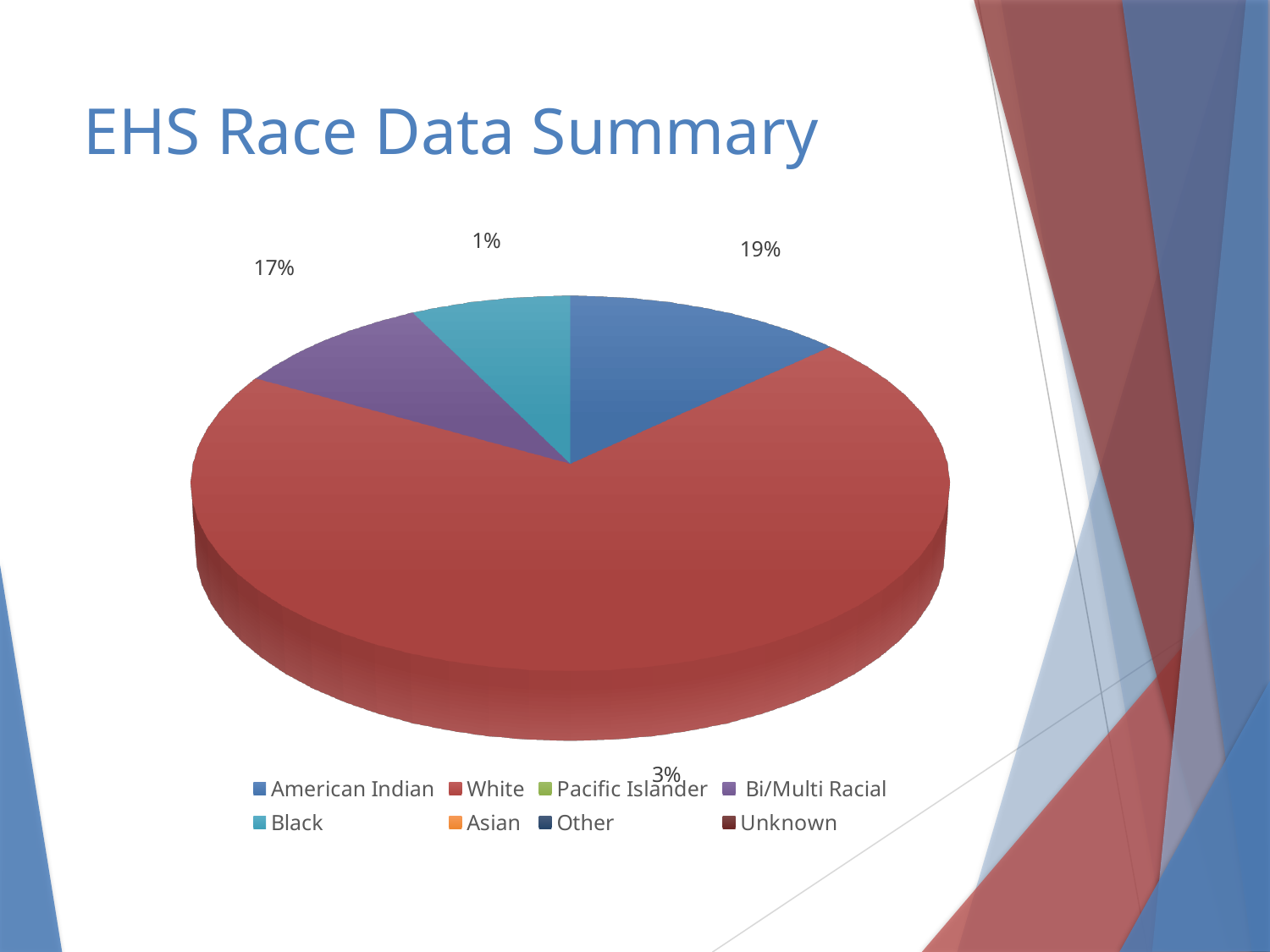
How many categories does the legend of the pie chart list? 8 Which slice is larger, White or American Indian? White What is the title of the chart on the slide? EHS Race Data Summary Which category has the largest slice of the pie? White What percentage is shown for the American Indian slice? 19% Which slice is larger, American Indian or Black? American Indian Which slice is larger, Bi/Multi Racial or Black? Bi/Multi Racial What colour represents the White category in the pie chart? red What kind of chart is shown on the slide? pie chart